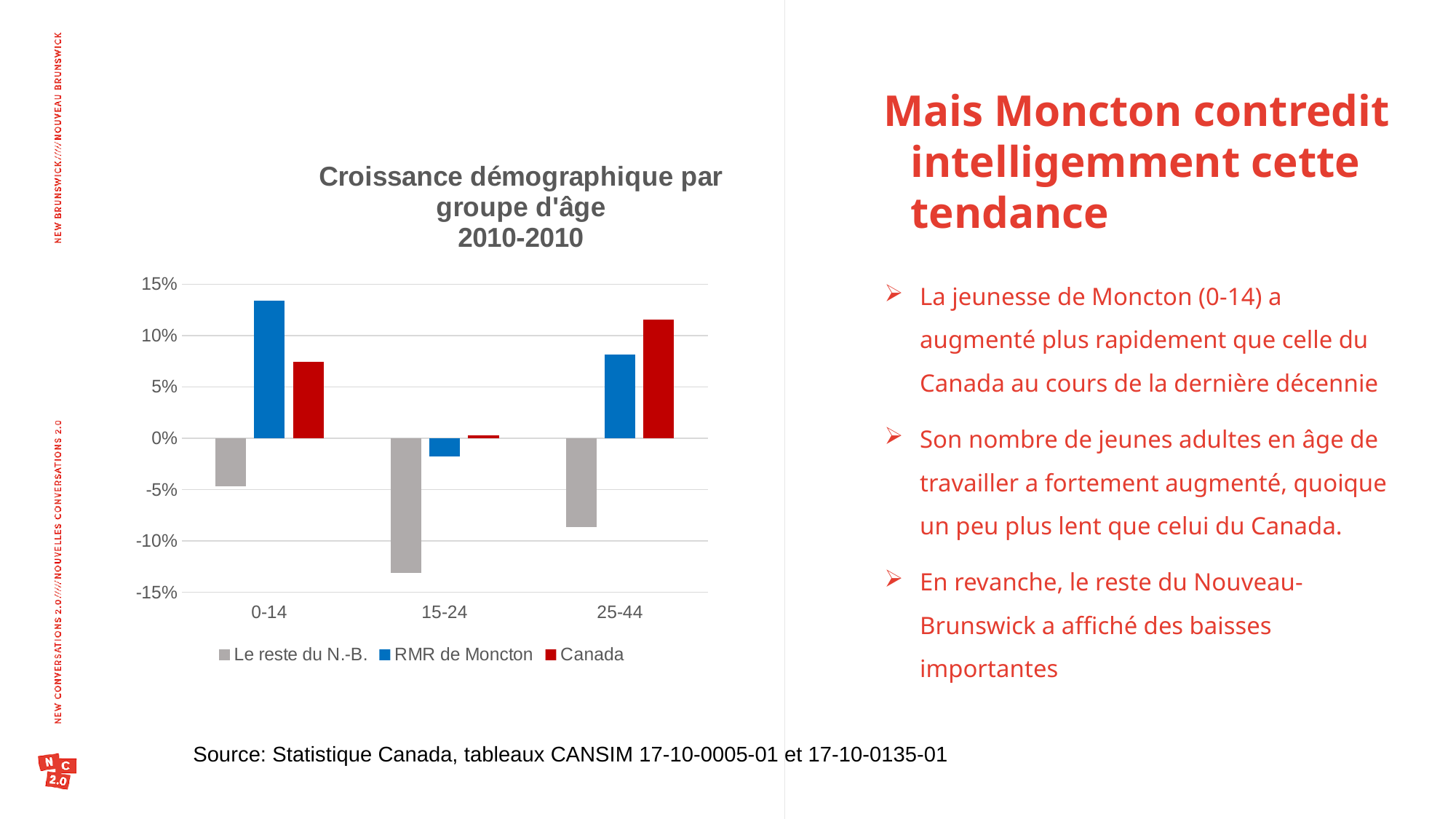
Is the value for Canada in the 25-44 age group greater or less than 10%? greater How many age groups are shown on the x axis of the chart? 3 What is the title of the chart? Croissance démographique par groupe d'âge 2010-2010 How many series does the chart legend list? 3 For the 0-14 age group, which is larger: RMR de Moncton or Canada? RMR de Moncton What colour represents Canada in the chart legend? red What kind of chart is shown on the slide? bar chart For the 25-44 age group, which is larger: RMR de Moncton or Canada? Canada Which age group has the lowest value for Le reste du N.-B.? 15-24 Is the value for RMR de Moncton in the 0-14 age group greater or less than 10%? greater Is the value for Le reste du N.-B. in the 15-24 age group greater or less than -10%? less Which age group has the highest value for RMR de Moncton? 0-14